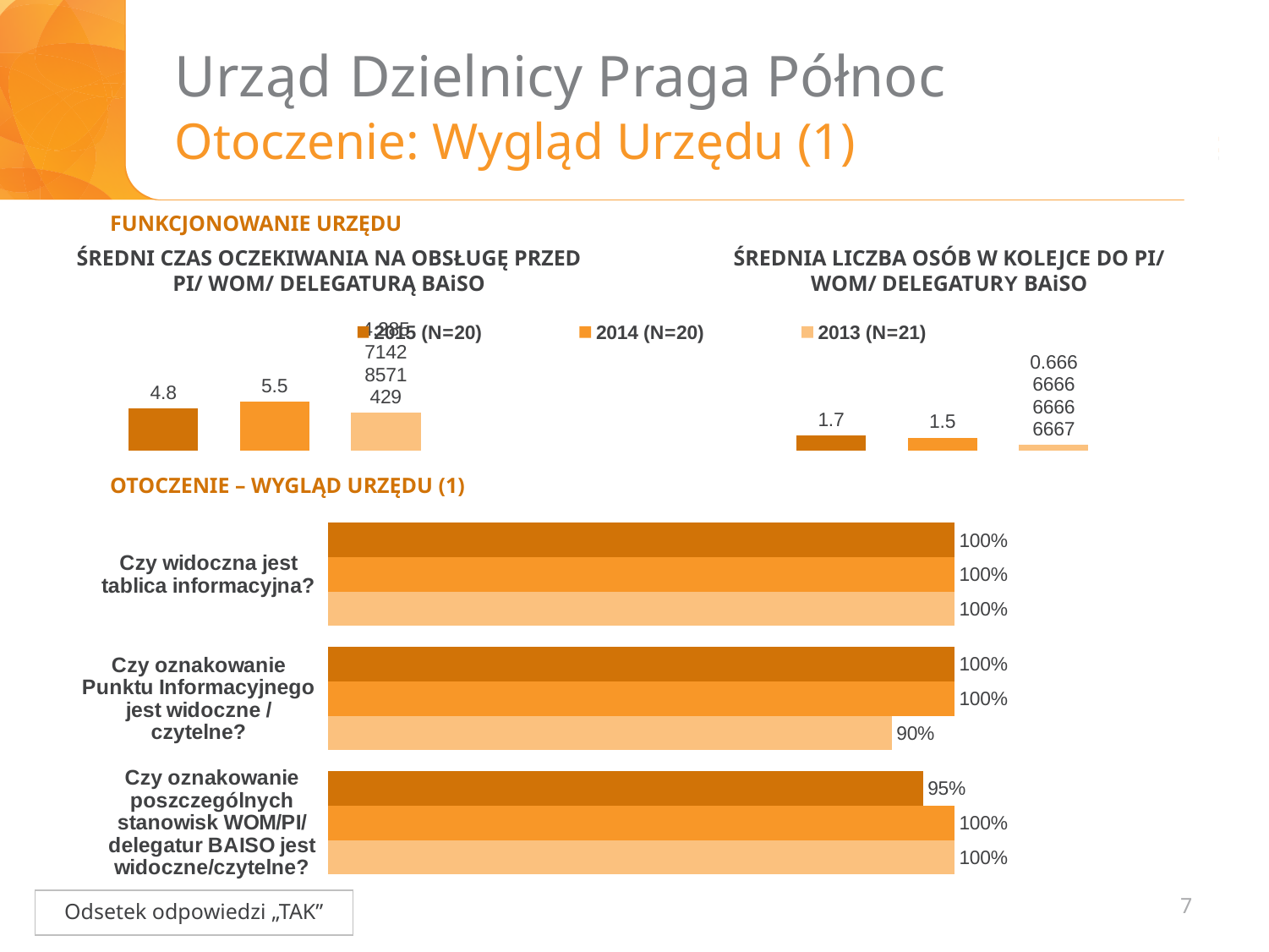
In the bottom chart 'OTOCZENIE – WYGLĄD URZĘDU (1)', what is the 2013 (N=21) value for 'Czy oznakowanie Punktu Informacyjnego jest widoczne / czytelne?'? 90% In the chart 'ŚREDNIA LICZBA OSÓB W KOLEJCE DO PI/ WOM/ DELEGATURY BAiSO', what is the value for 2014 (N=20)? 1.5 In the chart 'ŚREDNIA LICZBA OSÓB W KOLEJCE DO PI/ WOM/ DELEGATURY BAiSO', is the value for 2015 or 2014 larger? 2015 In the chart 'ŚREDNIA LICZBA OSÓB W KOLEJCE DO PI/ WOM/ DELEGATURY BAiSO', what is the value for 2015 (N=20)? 1.7 In the chart 'ŚREDNIA LICZBA OSÓB W KOLEJCE DO PI/ WOM/ DELEGATURY BAiSO', which year has the lowest value? 2013 (N=21) In the chart 'ŚREDNI CZAS OCZEKIWANIA NA OBSŁUGĘ PRZED PI/ WOM/ DELEGATURĄ BAiSO', what is the value for 2014 (N=20)? 5.5 In the chart 'ŚREDNI CZAS OCZEKIWANIA NA OBSŁUGĘ PRZED PI/ WOM/ DELEGATURĄ BAiSO', what is the value for 2015 (N=20)? 4.8 In the bottom chart 'OTOCZENIE – WYGLĄD URZĘDU (1)', what is the 2015 (N=20) value for 'Czy oznakowanie poszczególnych stanowisk WOM/PI/ delegatur BAISO jest widoczne/czytelne?'? 95% In the chart 'ŚREDNI CZAS OCZEKIWANIA NA OBSŁUGĘ PRZED PI/ WOM/ DELEGATURĄ BAiSO', which year has the highest value? 2014 (N=20) What type of chart is the bottom chart 'OTOCZENIE – WYGLĄD URZĘDU (1)'? Bar chart How many series does the legend list for the charts on this slide? 3 In the chart 'ŚREDNI CZAS OCZEKIWANIA NA OBSŁUGĘ PRZED PI/ WOM/ DELEGATURĄ BAiSO', what is the difference between the 2014 and 2015 values? 0.7